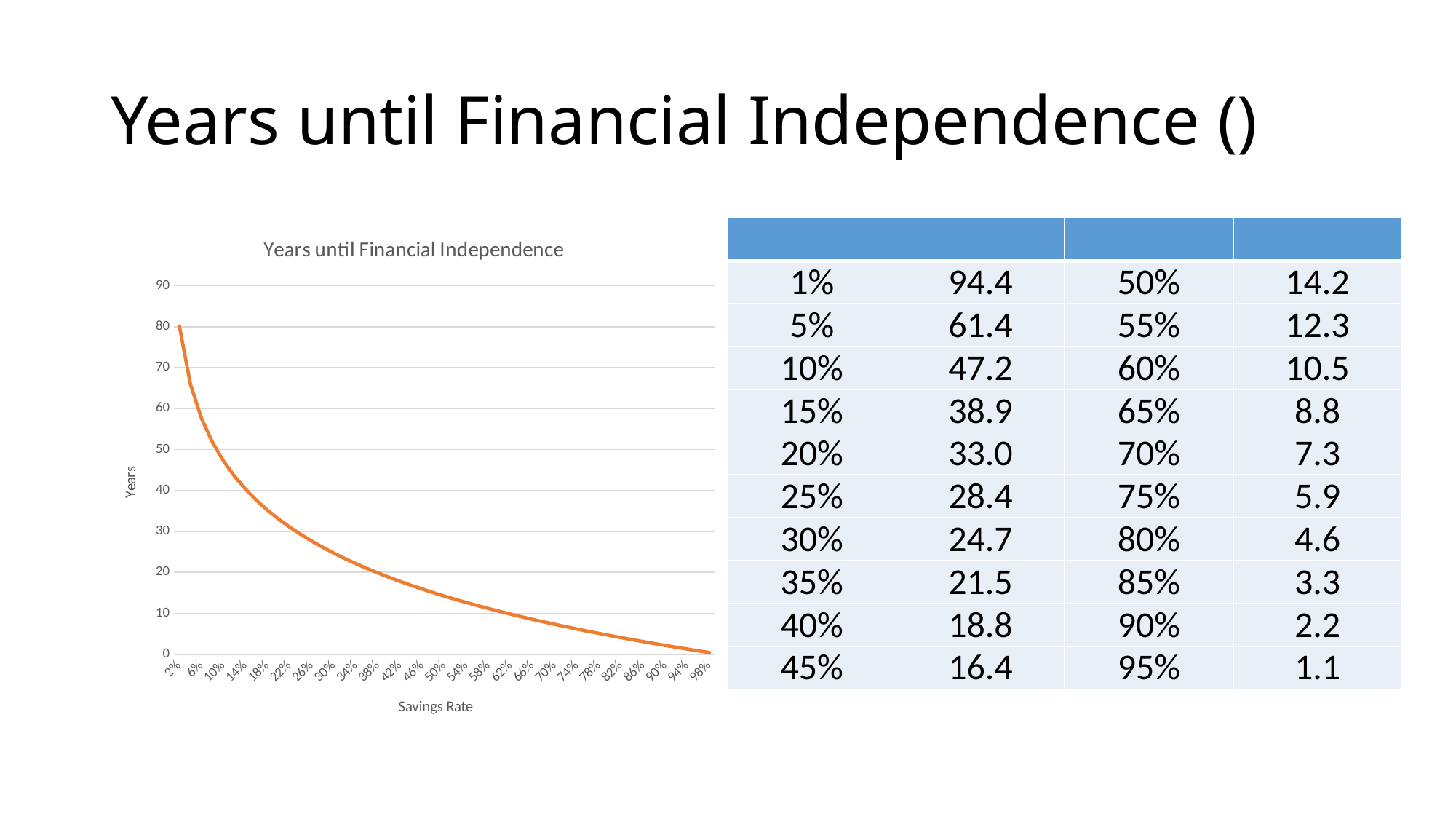
Is the value for a 50% savings rate greater or less than 20? less How many savings rate tick labels are shown along the x axis of the chart? 25 Is the value for a 70% savings rate greater or less than 10? less What is the title of the chart? Years until Financial Independence What kind of chart is shown on the slide? line chart At which savings rate on the x axis is the plotted value highest? 2% Is the value for a 2% savings rate greater or less than 70? greater Do the values in the chart rise or fall as the savings rate increases along the x axis? fall What is the label of the x axis of the chart? Savings Rate At which savings rate on the x axis is the plotted value lowest? 98% Which has the larger value in the chart, a 6% savings rate or a 30% savings rate? 6%